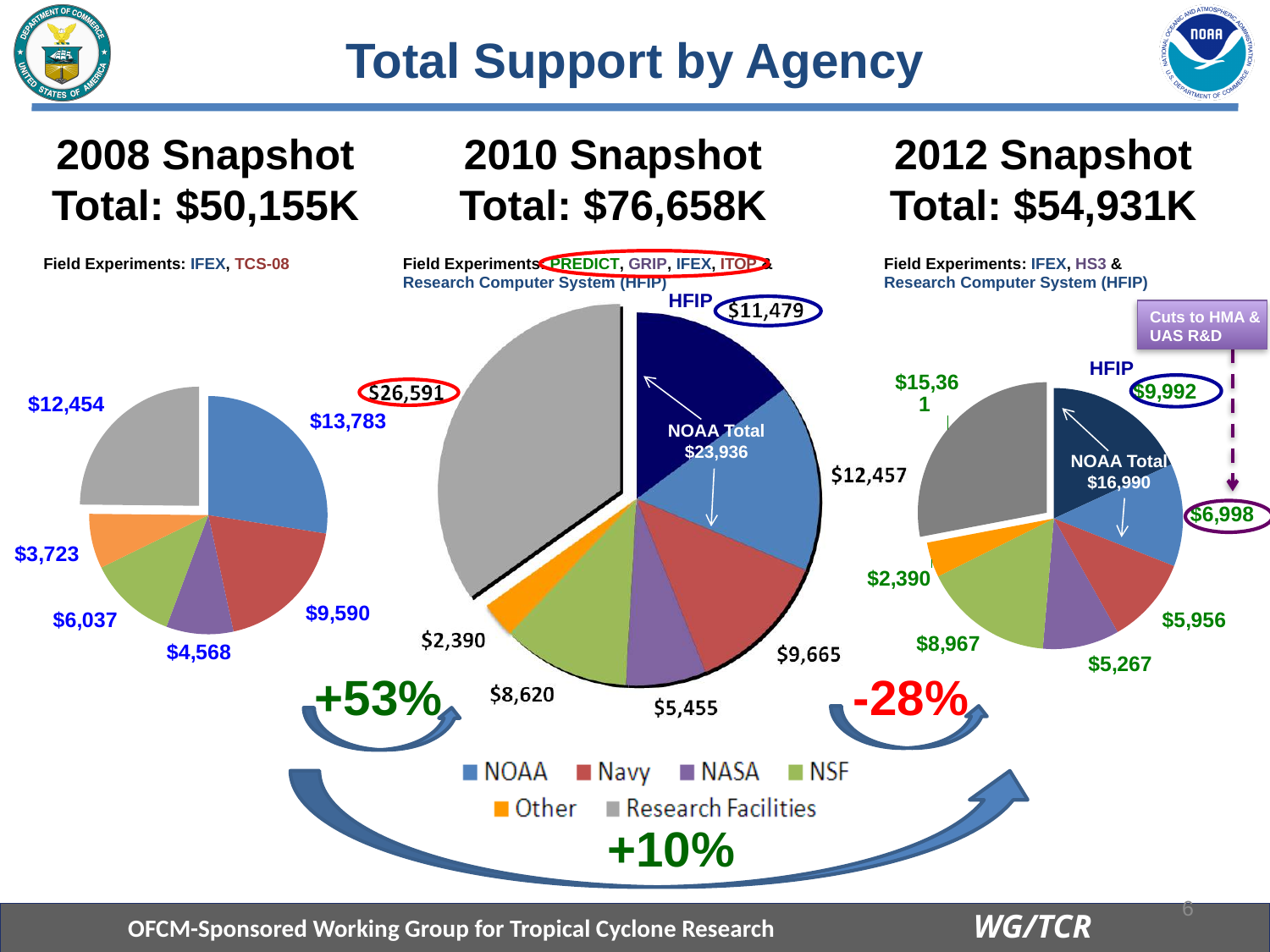
What kind of chart is used for the 2008 Snapshot? Pie chart In the 2008 Snapshot pie chart, what is the value for NOAA? $13,783 In the 2012 Snapshot pie chart, which is larger, the Navy value or the NASA value? Navy In the 2012 Snapshot pie chart, what is the value for NSF? $8,967 In the 2010 Snapshot pie chart, what is the difference between the Navy value and the NASA value? $4,210 In the 2010 Snapshot pie chart, what is the value for Research Facilities? $26,591 In the 2012 Snapshot pie chart, what is the NOAA Total shown? $16,990 In the 2010 Snapshot pie chart, which category has the largest slice? Research Facilities In the 2008 Snapshot pie chart, what is the value for Research Facilities? $12,454 In the 2008 Snapshot pie chart, which agency has the smallest slice? Other In the 2010 Snapshot pie chart, what is the value for HFIP? $11,479 How many entries does the shared legend list? 6